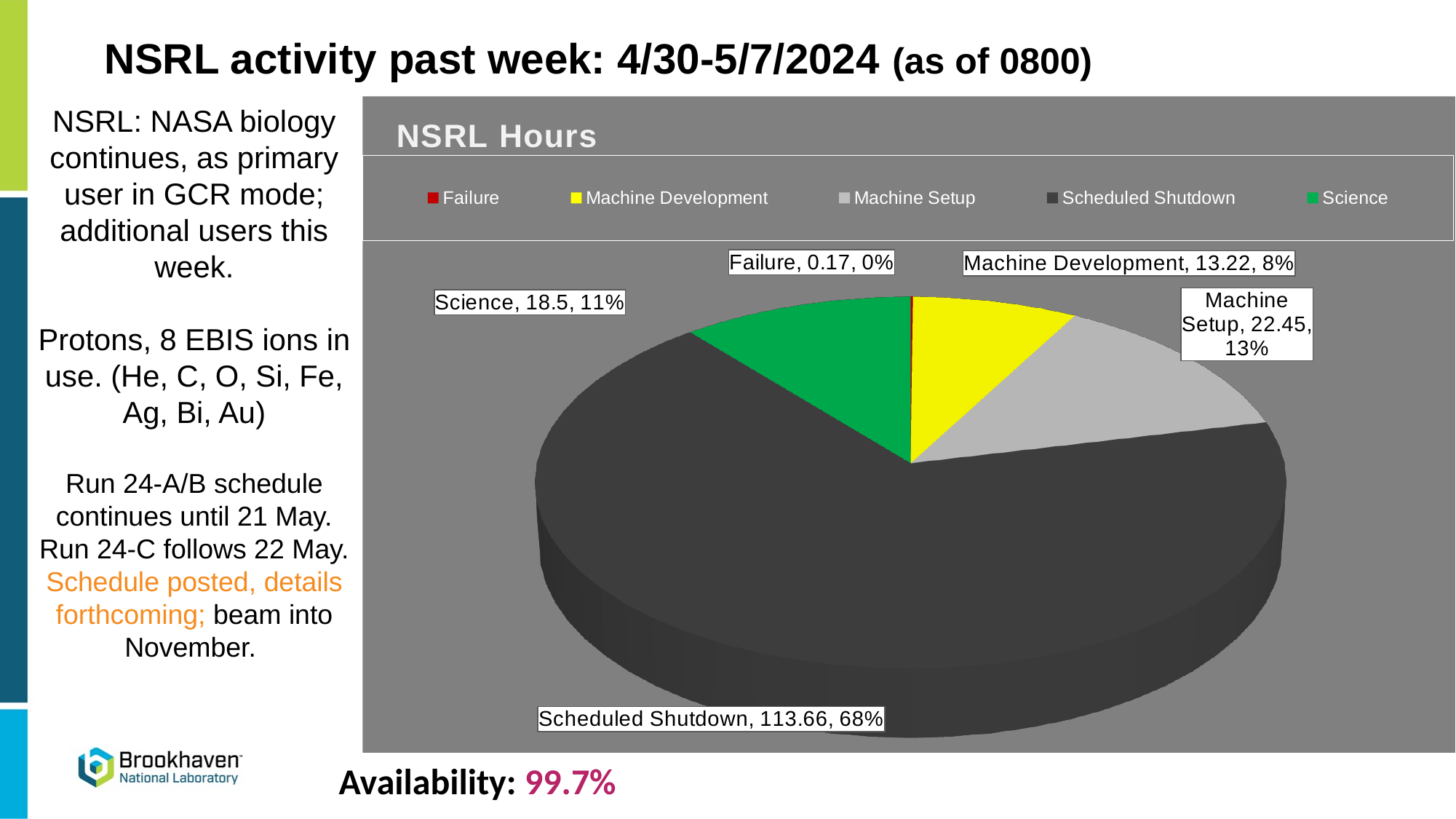
What is the difference in hours between Machine Setup and Machine Development? 9.23 What is the title of the chart? NSRL Hours How many hours are shown for Scheduled Shutdown? 113.66 What type of chart is shown on the slide? pie chart Which category has the smallest slice of the pie? Failure Which category has the largest slice of the pie? Scheduled Shutdown How many categories does the legend of the NSRL Hours chart list? 5 Which has more hours, Machine Setup or Science? Machine Setup How many hours are shown for Machine Setup? 22.45 How many hours are shown for Science? 18.5 What percentage share of the pie does Scheduled Shutdown have? 68% What percentage share of the pie does Machine Development have? 8%